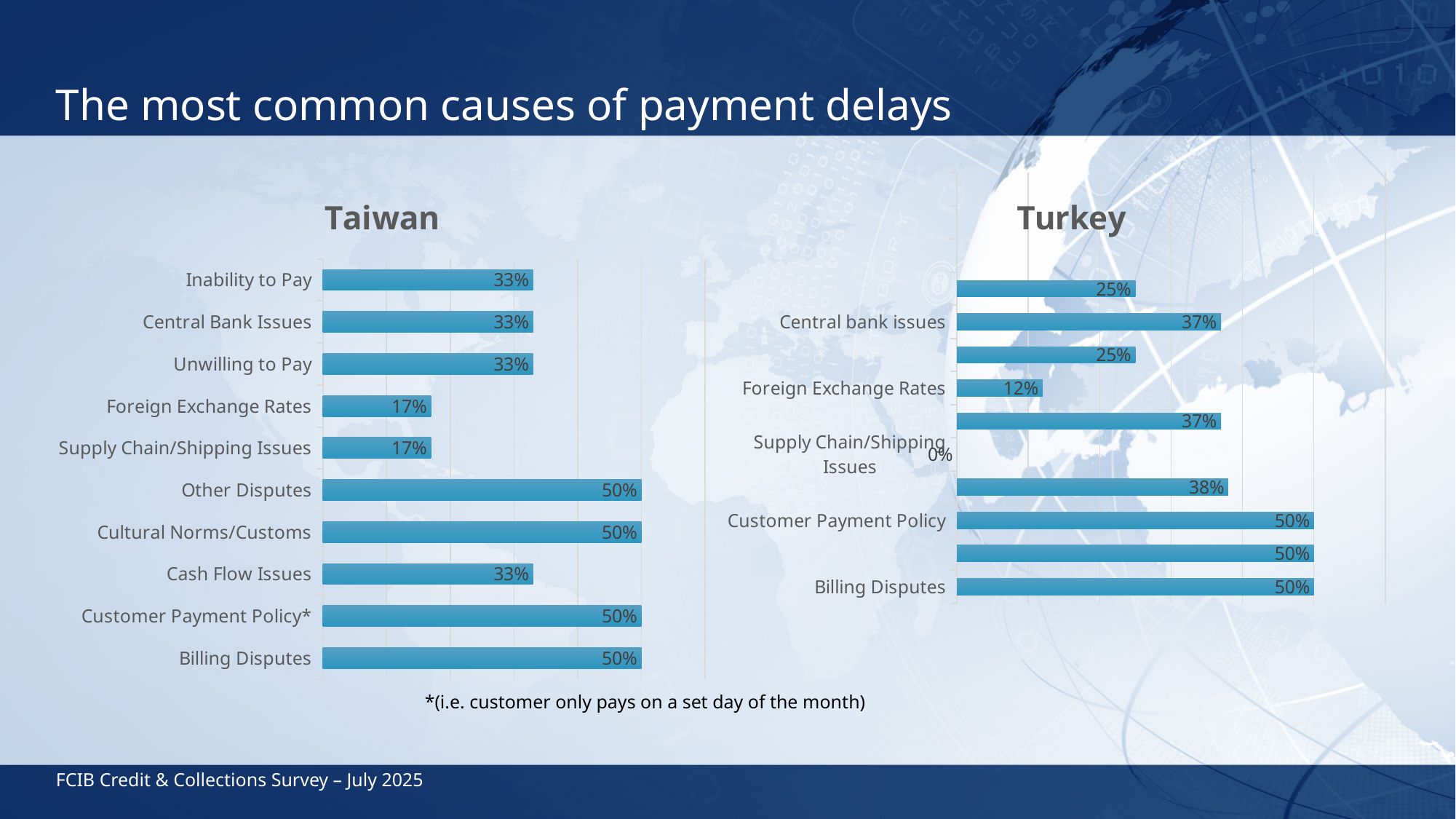
What is the title of the slide? The most common causes of payment delays In the Taiwan chart, what is the value for Foreign Exchange Rates? 17% In the Turkey chart, what is the value for Central bank issues? 37% What type of chart is the Taiwan chart? Bar chart In the Taiwan chart, which is larger: Cultural Norms/Customs or Inability to Pay? Cultural Norms/Customs In the Taiwan chart, what is the difference between Billing Disputes and Supply Chain/Shipping Issues? 33% How many categories are shown in the Taiwan chart? 10 In the Taiwan chart, what is the value for Cash Flow Issues? 33% In the Turkey chart, what is the value for Foreign Exchange Rates? 12% In the Taiwan chart, what percentage is shown for Other Disputes? 50% Which chart shows a higher value for Foreign Exchange Rates, Taiwan or Turkey? Taiwan In the Turkey chart, which labelled category has the lowest value? Supply Chain/Shipping Issues